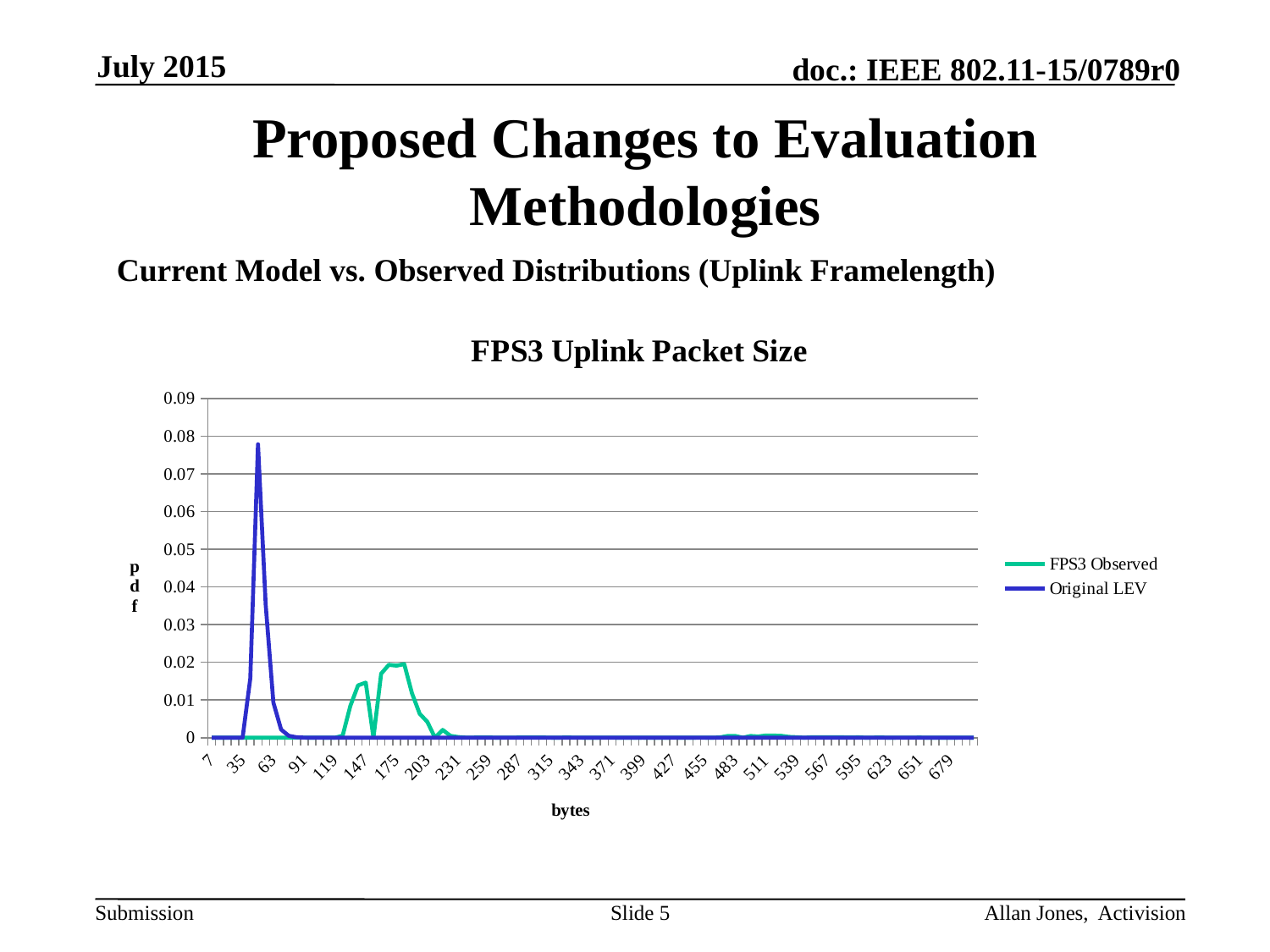
How many series does the legend list? 2 Which series has its peak at a larger number of bytes, FPS3 Observed or Original LEV? FPS3 Observed What is the label of the x axis? bytes What is the title of the chart? FPS3 Uplink Packet Size Is the value of the Original LEV series at 343 bytes greater or less than 0.01? less Is the peak value of the FPS3 Observed series greater or less than 0.03? less What is the highest value shown on the y axis? 0.09 What kind of chart is shown on the slide? line chart Which series reaches the higher peak, FPS3 Observed or Original LEV? Original LEV Is the peak value of the Original LEV series greater or less than 0.05? greater After its peak, does the Original LEV series rise or fall as bytes increase? fall